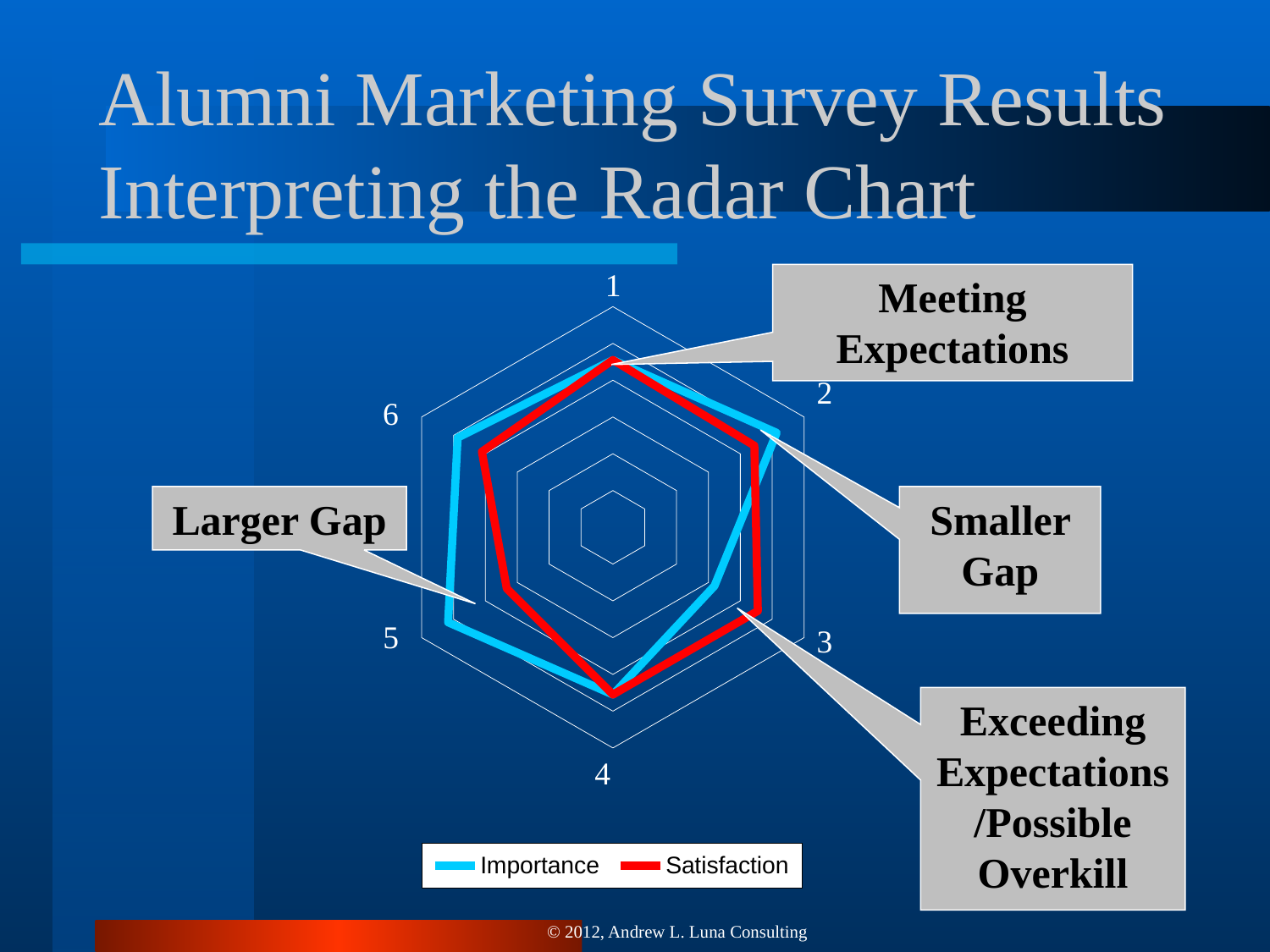
At category 4, which series has the larger value, Importance or Satisfaction? Neither; they are equal at category 4 Which series is plotted in red? Satisfaction Which series is plotted in cyan (light blue)? Importance How many series does the legend list? 2 Which category is labelled as showing the 'Larger Gap' between the two series? 5 What kind of chart is shown on the slide? Radar chart For the Importance series, which category has the lowest value? 3 For the Satisfaction series, which category has the lowest value? 5 How many categories (axes) does the radar chart have? 6 At category 6, which series has the larger value, Importance or Satisfaction? Importance At category 5, which series has the larger value, Importance or Satisfaction? Importance